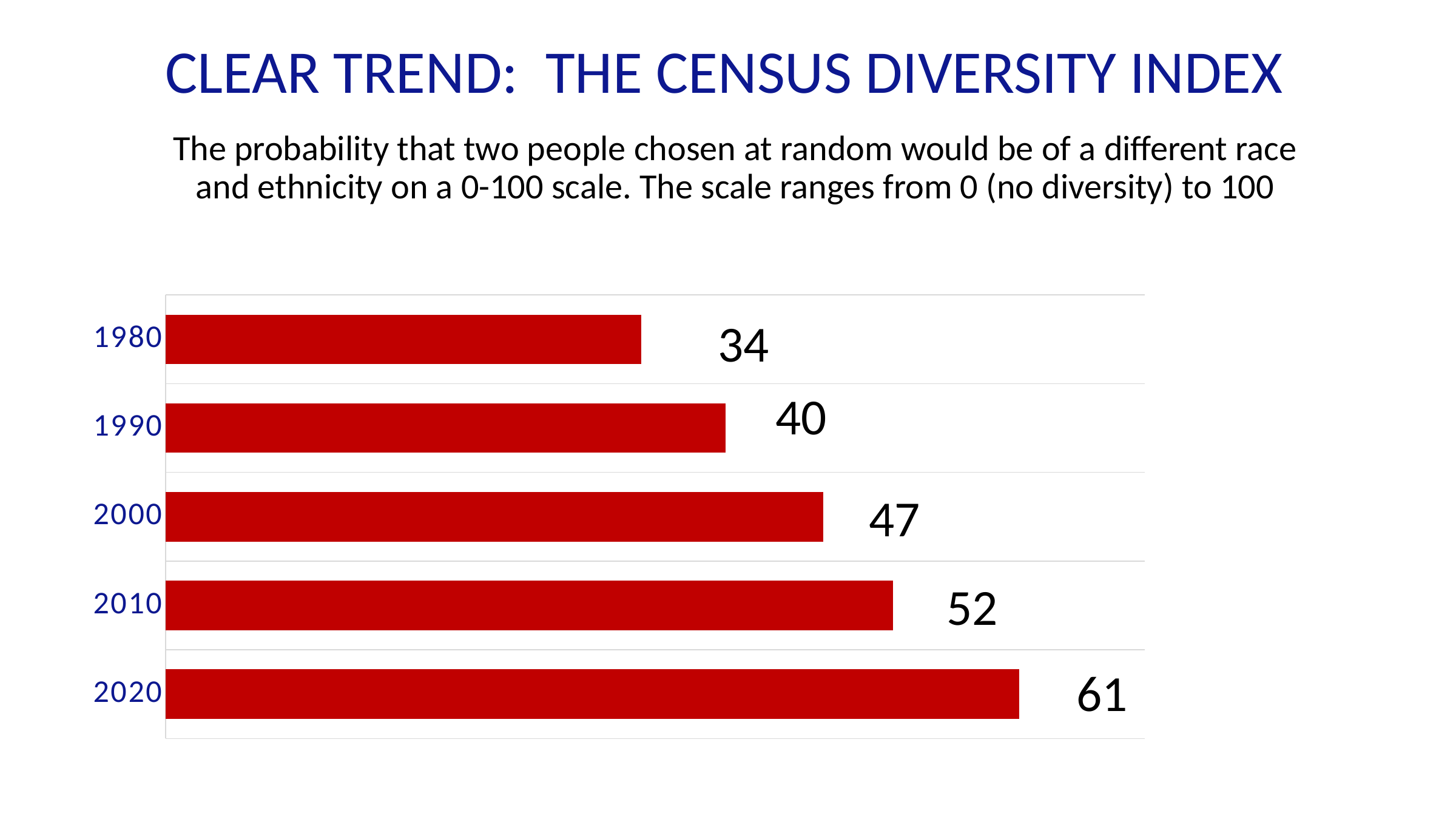
What colour are the bars in the chart? Red What is the diversity index value for 2000? 47 What kind of chart is shown on the slide? Bar chart Which year has a larger diversity index value, 1990 or 2010? 2010 Do the diversity index values rise or fall from 1980 to 2020? Rise What is the diversity index value for 2020? 61 How many years are shown in the chart? 5 Which year has the highest diversity index value? 2020 What is the difference between the diversity index values for 2020 and 1980? 27 What is the difference between the diversity index values for 2010 and 1990? 12 Which year has the lowest diversity index value? 1980 What is the diversity index value for 1980? 34